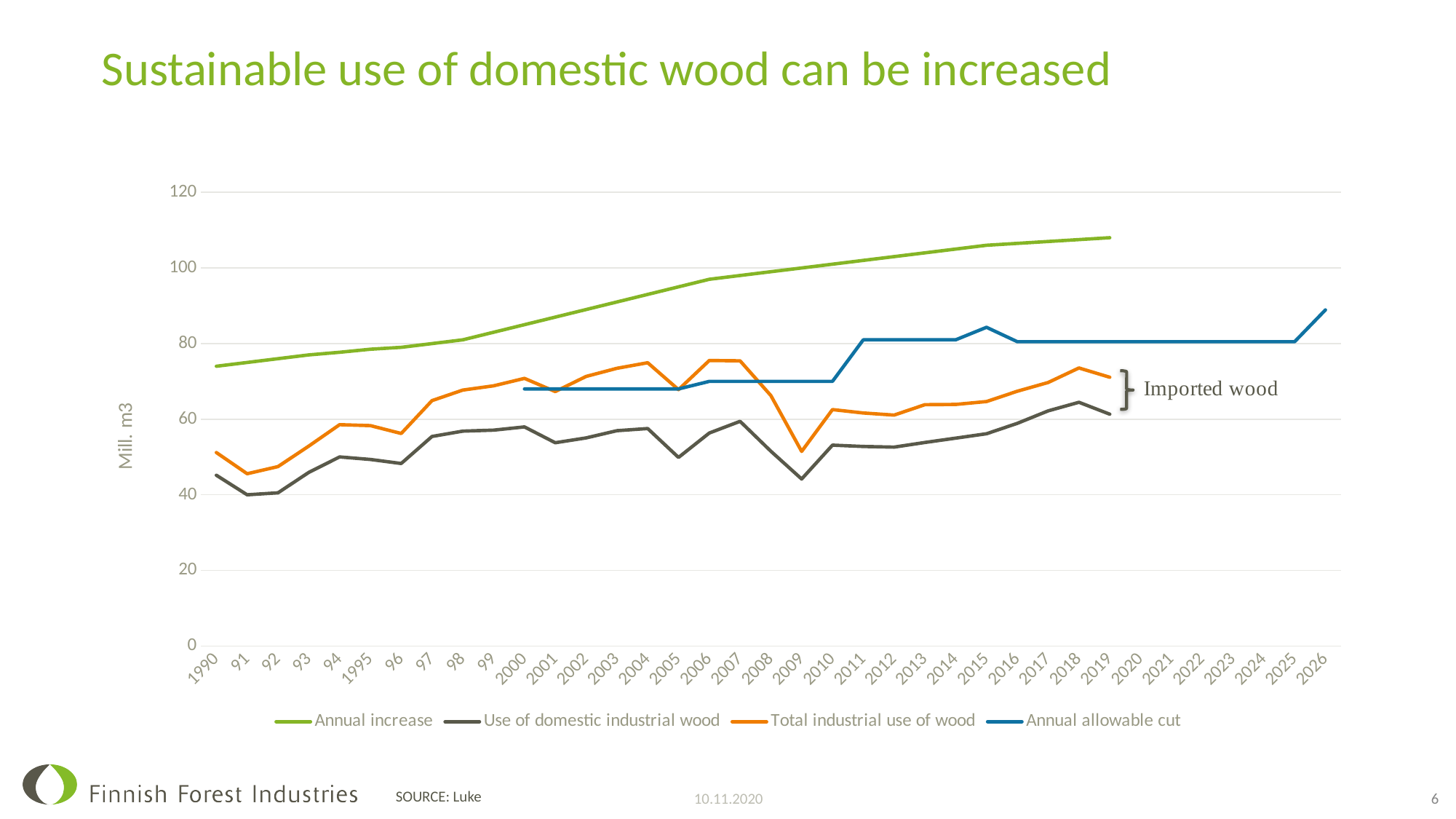
What kind of chart is shown on the slide? line chart How many series does the legend list? 4 How many years are labelled along the x axis? 37 What is the label on the y axis? Mill. m3 Which series has the lowest value in 1991? Use of domestic industrial wood In 2019, which is larger: Annual increase or Use of domestic industrial wood? Annual increase Is the value of Use of domestic industrial wood in 2009 greater or less than 60? less Is the value of Annual increase in 1990 greater or less than 80? less Is the value of Annual allowable cut in 2026 greater or less than 80? greater Which series has the highest value in 2019? Annual increase